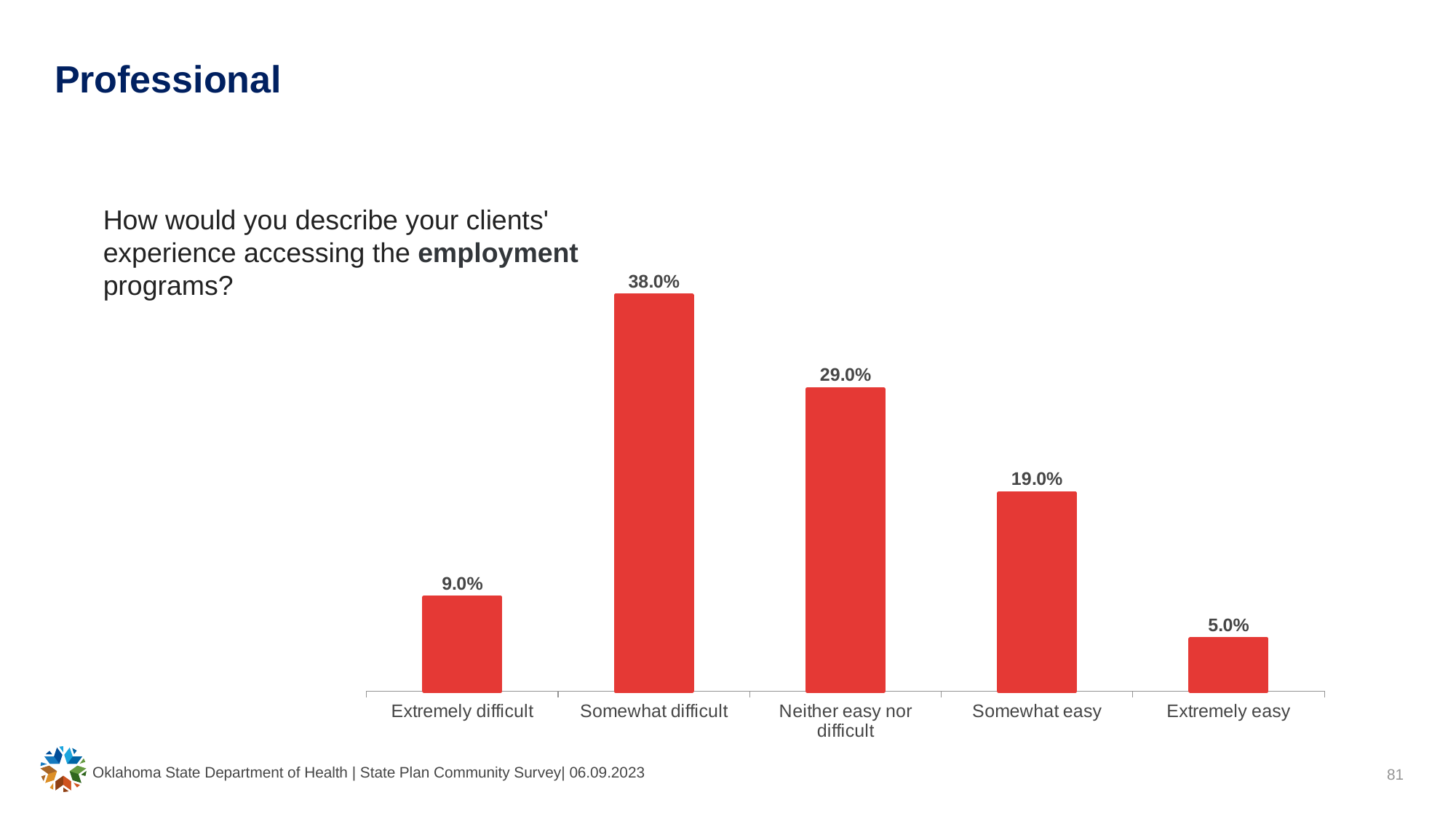
What is the value for Neither easy nor difficult? 29.0% What is the value for Somewhat difficult? 38.0% What is the difference between the values for Somewhat easy and Extremely easy? 14.0% What survey question does the chart present? How would you describe your clients' experience accessing the employment programs? Which is larger, the value for Extremely difficult or the value for Somewhat easy? Somewhat easy What is the value for Extremely difficult? 9.0% What is the difference between the values for Somewhat difficult and Neither easy nor difficult? 9.0% Which category has the lowest value? Extremely easy What kind of chart is shown on the slide? Bar chart What is the value for Extremely easy? 5.0% Which category has the highest value? Somewhat difficult How many categories are shown on the x axis? 5